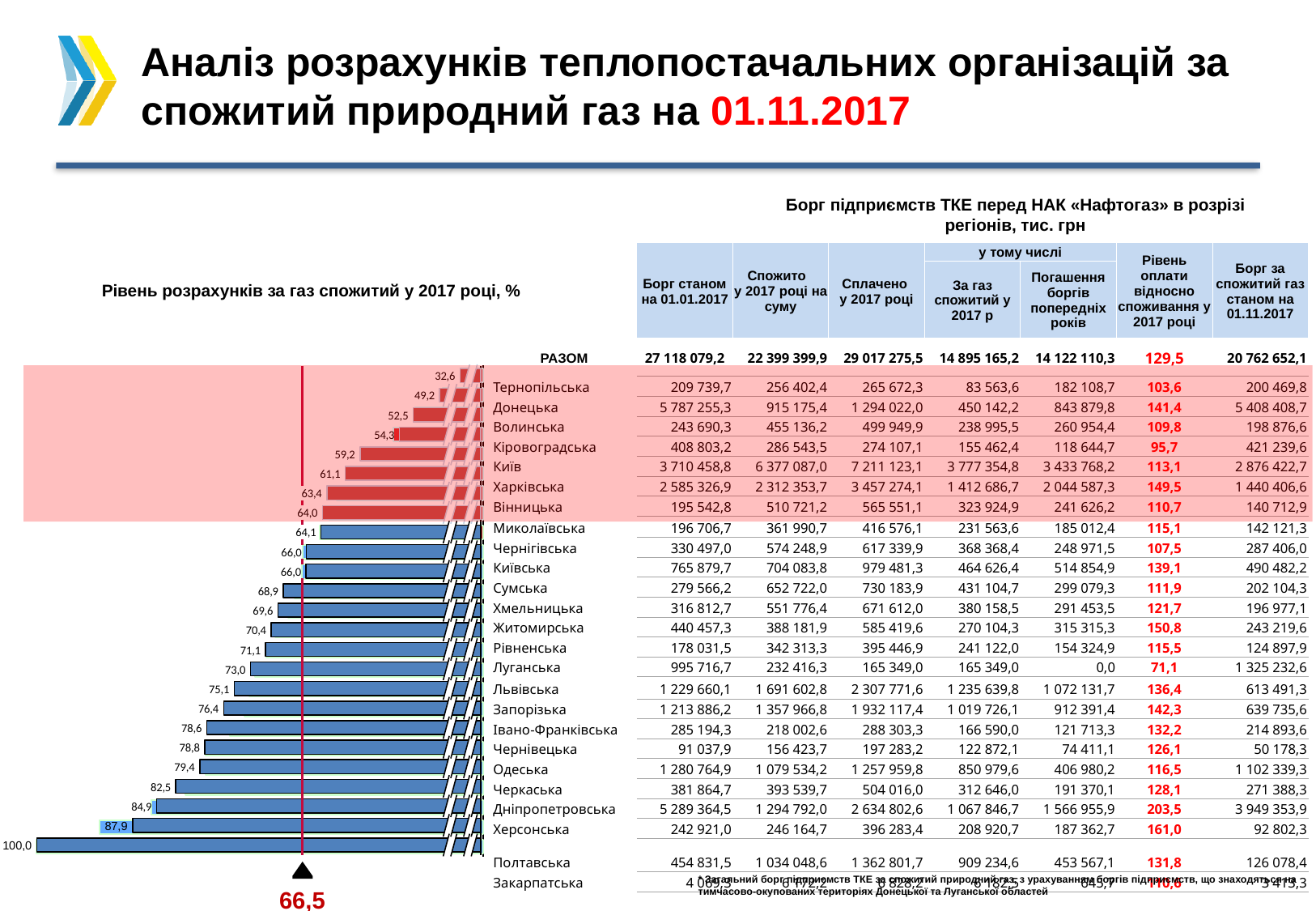
How many regions are shown as bars in the bar chart? 25 Which region has the lowest value in the bar chart? Тернопільська What is the value for Луганська in the bar chart? 71,1 What is the value for Тернопільська in the bar chart? 32,6 What is the title of the bar chart? Рівень розрахунків за газ спожитий у 2017 році, % Which region has the highest value in the bar chart? Закарпатська What is the value for Київ in the bar chart? 59,2 What is the difference between the values for Закарпатська and Тернопільська in the bar chart? 67,4 What is the value for Полтавська in the bar chart? 87,9 Which has a larger value in the bar chart, Донецька or Харківська? Харківська What type of chart is shown on the slide? bar chart What value is marked by the red vertical line with the triangle below the bar chart? 66,5